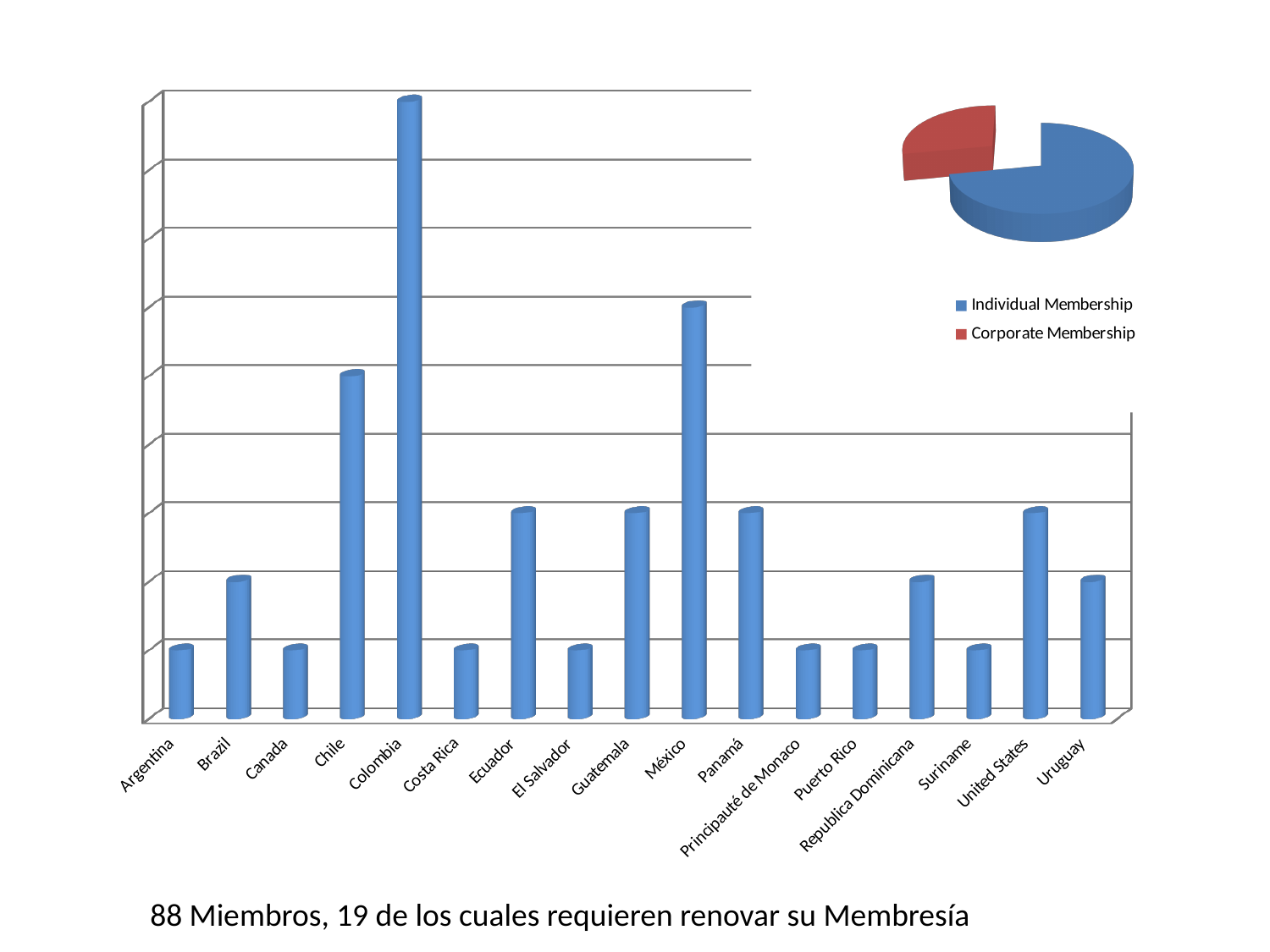
In the bar chart on the left, which is larger, the value for Colombia or the value for México? Colombia How many countries are shown on the x axis of the bar chart on the left? 17 In the bar chart on the left, which country has the highest bar? Colombia What kind of chart is the chart in the top right of the slide? Pie chart What kind of chart is the chart on the left of the slide? Bar chart In the pie chart in the top right, which slice is larger, Individual Membership or Corporate Membership? Individual Membership In the bar chart on the left, which is larger, the value for Brazil or the value for Argentina? Brazil How many entries does the legend of the pie chart in the top right list? 2 In the bar chart on the left, which country has the second-highest bar? México